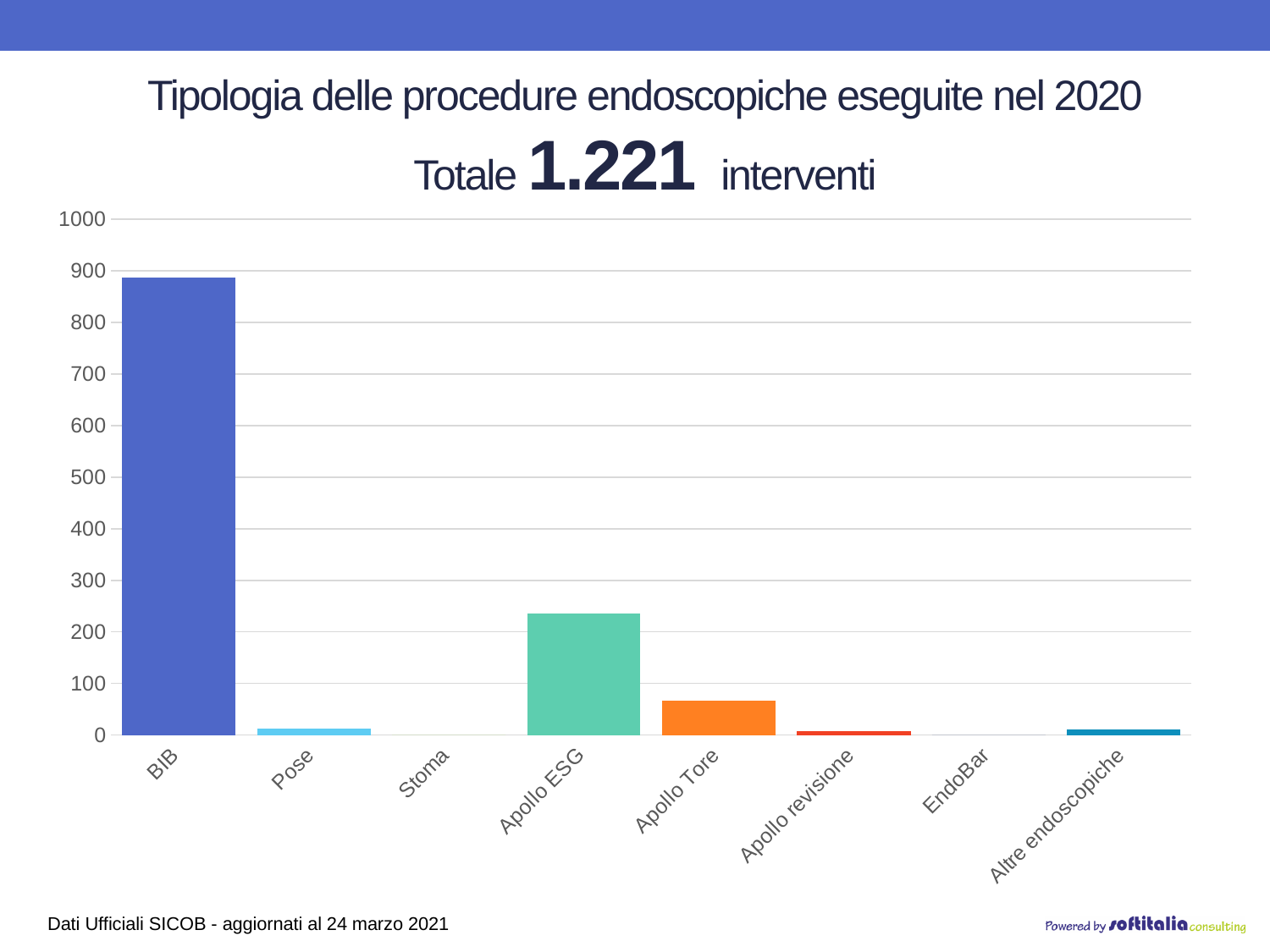
Which procedure category has the highest value? BIB Is the value for Pose greater or less than 100? less Is the value for Apollo ESG greater or less than 200? greater Which is larger, the value for Apollo Tore or the value for Pose? Apollo Tore What kind of chart is shown on the slide? bar chart What year do the endoscopic procedures in the chart title refer to? 2020 Is the value for Apollo ESG greater or less than 300? less What total number of interventions is stated in the chart title? 1.221 Which is larger, the value for Apollo ESG or the value for Apollo Tore? Apollo ESG How many procedure categories are shown on the x axis? 8